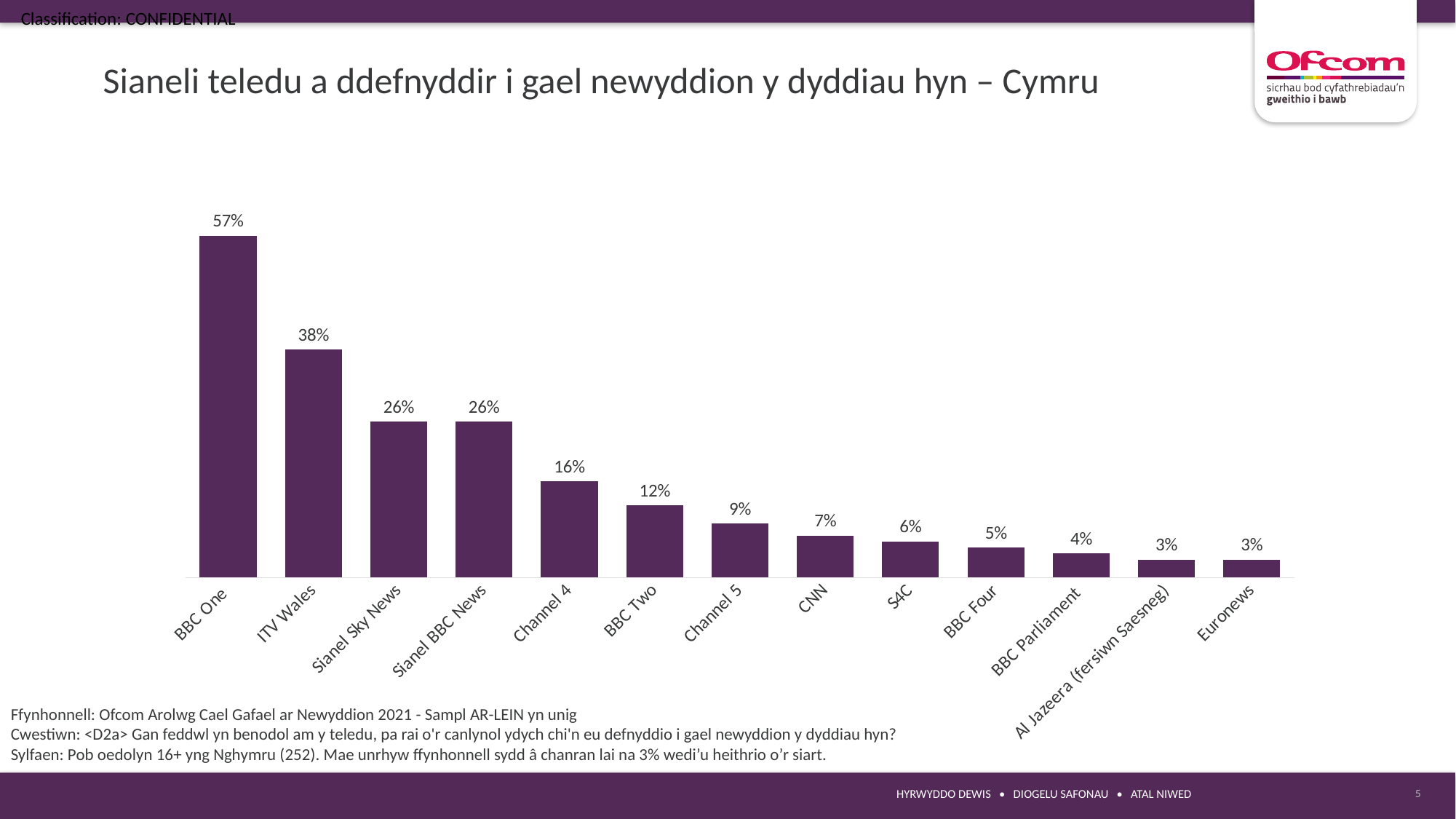
Which has a larger value, CNN or S4C? CNN What percentage is shown for BBC One? 57% Do the values rise or fall from left to right across the chart? Fall Which has a larger value, Channel 5 or BBC Four? Channel 5 What is the value for Channel 4? 16% What kind of chart is shown on the slide? Bar chart What is the value for ITV Wales? 38% What is the difference between the values for BBC One and ITV Wales? 19% What is the difference between the values for Channel 4 and BBC Two? 4% What percentage is shown for S4C? 6% How many channels are shown in the chart? 13 Which channel has the highest value in the chart? BBC One